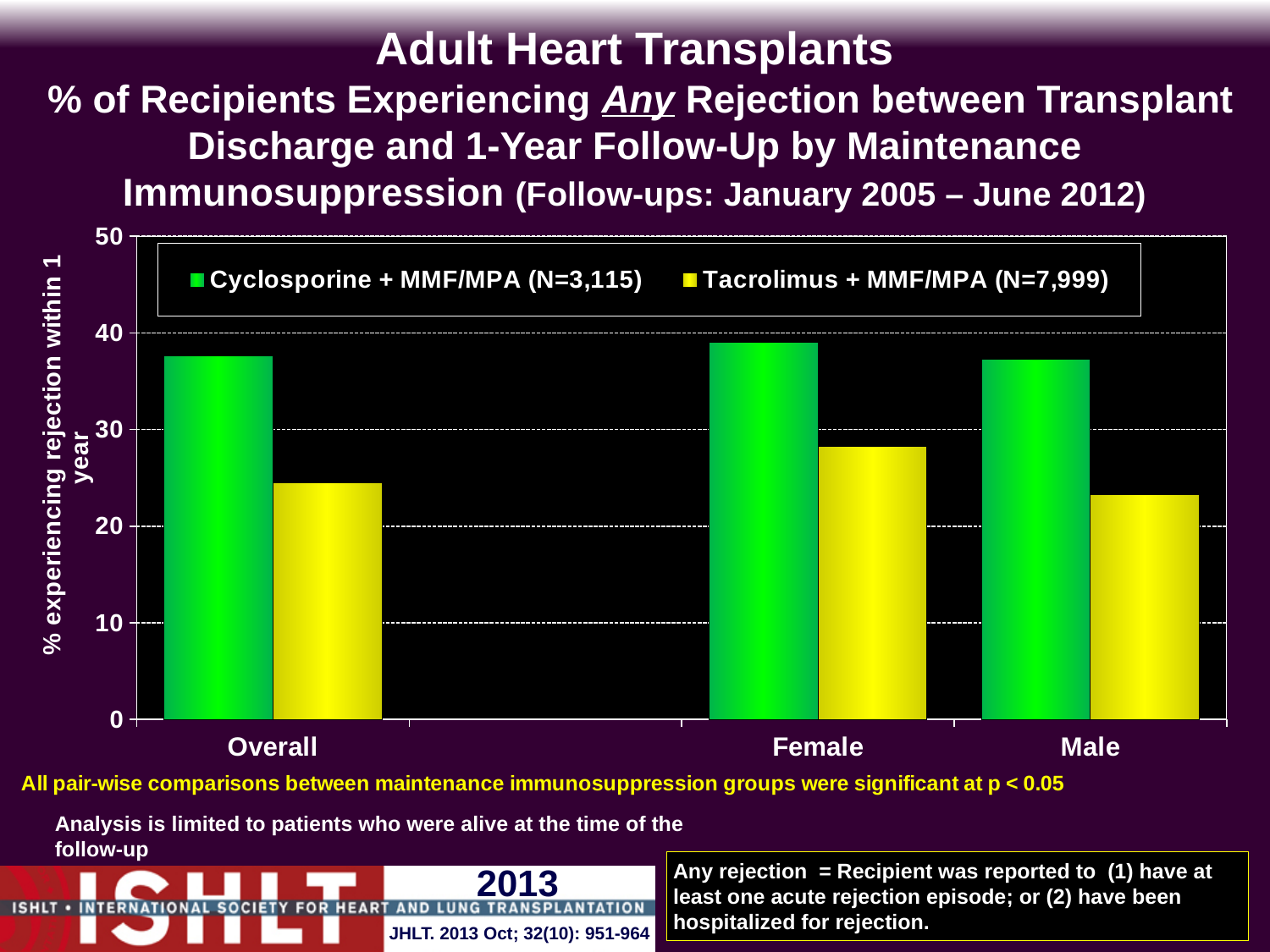
Which series has the higher value for the Overall category, Cyclosporine + MMF/MPA or Tacrolimus + MMF/MPA? Cyclosporine + MMF/MPA Which series has the higher value for the Female category? Cyclosporine + MMF/MPA What kind of chart is shown on the slide? bar chart Is the value for Tacrolimus + MMF/MPA in the Overall category greater or less than 30? less How many series does the legend list? 2 Among the three categories, which has the highest value for Tacrolimus + MMF/MPA? Female How many categories are shown on the x axis? 3 What is the sample size (N) given in the legend for the Tacrolimus + MMF/MPA series? 7,999 Is the value for Cyclosporine + MMF/MPA in the Overall category greater or less than 30? greater Which series has the higher value for the Male category? Cyclosporine + MMF/MPA Is the value for Tacrolimus + MMF/MPA in the Male category greater or less than 20? greater What colour are the bars for the Cyclosporine + MMF/MPA series? green